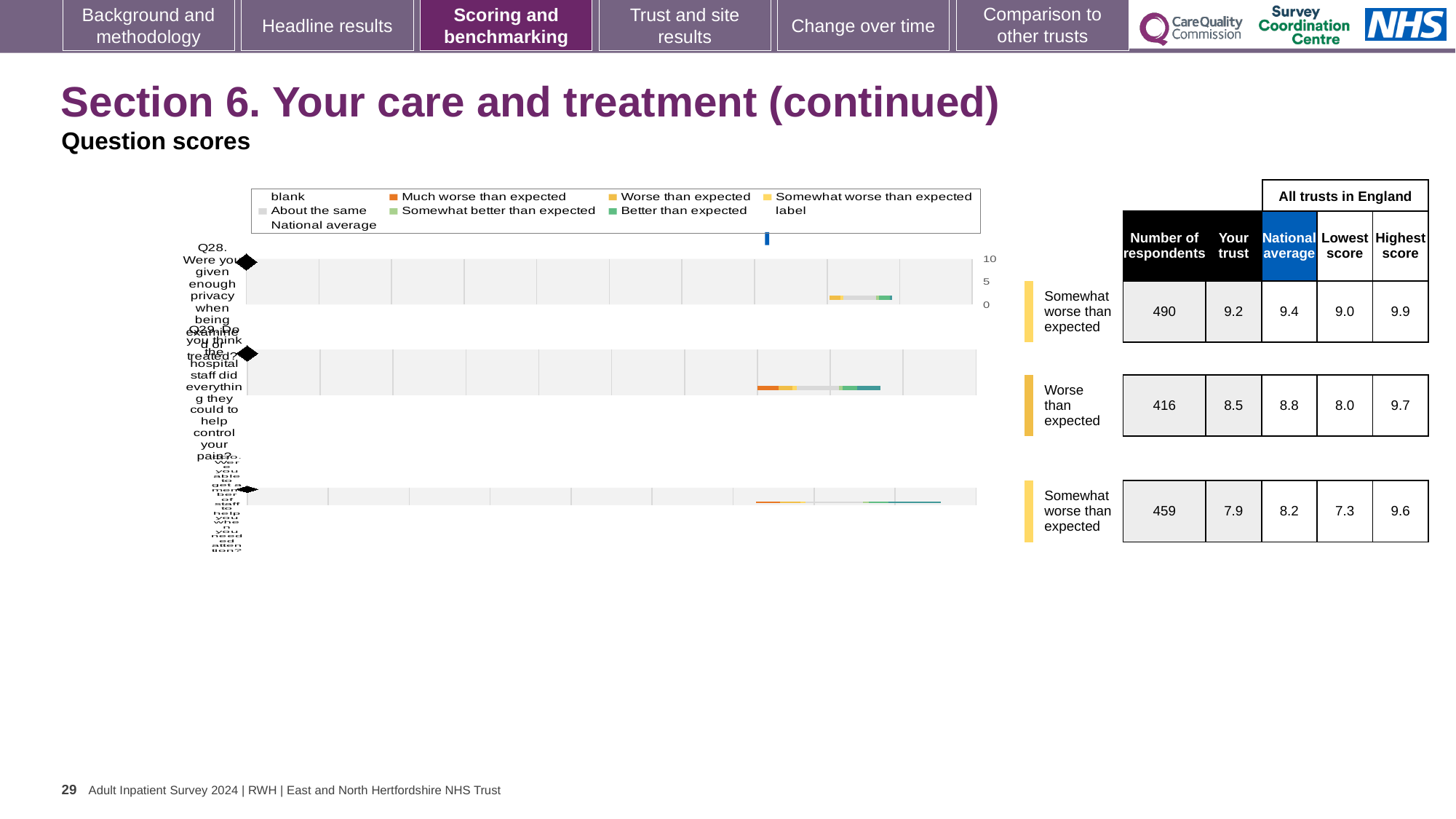
What kind of chart is used to show the question scores on this slide? bar chart What is the difference between the national average and the trust's score for Q30? 0.3 Which benchmark category is Q29 placed in? Worse than expected How many questions are plotted in the question scores chart? 3 Which question has the lowest 'Your trust' score? Q30 In the chart legend, which colour represents 'Much worse than expected'? orange What is the maximum value shown on the score axis of the chart? 10 What is the 'Your trust' score for Q28 (privacy when being examined or treated)? 9.2 What is the national average score for Q30 (able to get a member of staff to help when needed)? 8.2 What is the lowest score across all trusts in England for Q29? 8.0 How many respondents answered Q29 (hospital staff helping control pain)? 416 What is the highest score across all trusts in England for Q28? 9.9